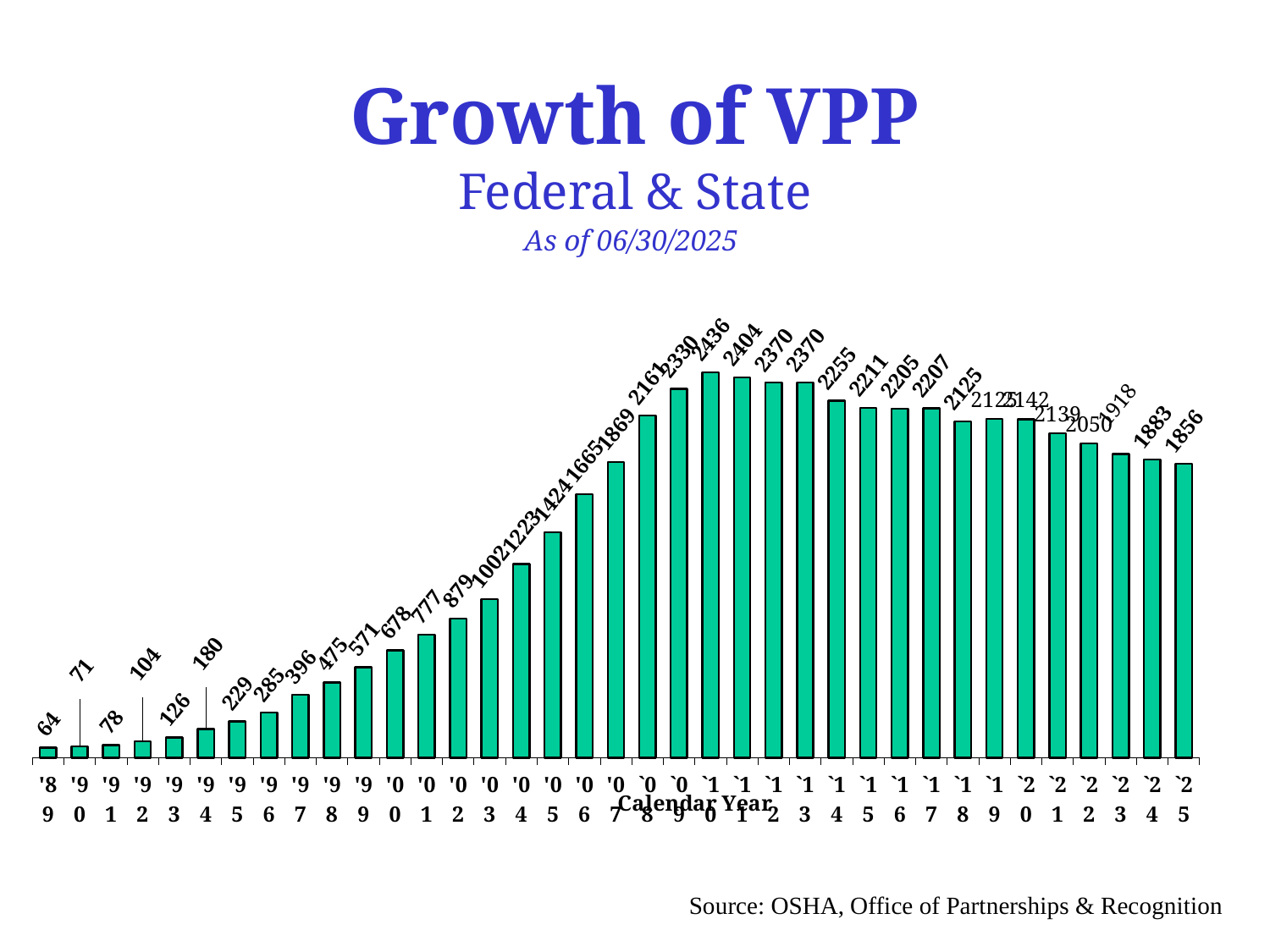
Do the values rise or fall from '89 to '10? rise What is the value for calendar year '08? 2161 What is the value for calendar year '10? 2436 What type of chart is shown on the slide? bar chart Which calendar year has the highest value? '10 What is the value for calendar year '89? 64 What is the value for calendar year '25? 1856 How many calendar years (bars) are plotted in the chart? 37 Which calendar year has the lowest value? '89 Which is larger, the value for '09 or the value for '11? '11 What is the label of the x axis? Calendar Year What is the difference between the value for '10 and the value for '25? 580